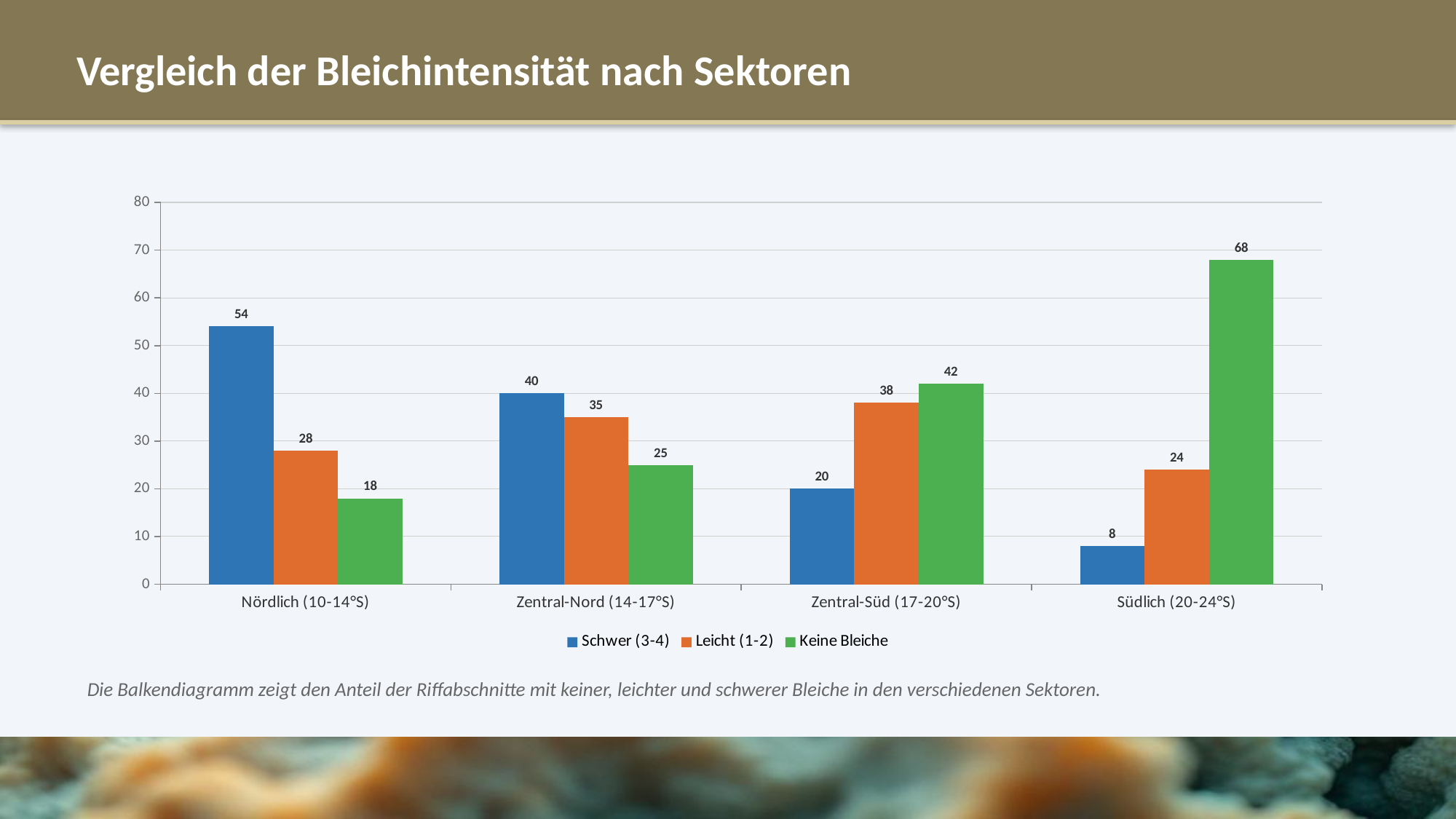
Do the Schwer (3-4) values rise or fall from Nördlich to Südlich along the x axis? Fall What is the value for Schwer (3-4) in the Nördlich (10-14°S) sector? 54 What kind of chart is shown on the slide? Bar chart What is the title of the slide? Vergleich der Bleichintensität nach Sektoren Which sector has the highest value for Schwer (3-4)? Nördlich (10-14°S) How many series does the legend list? 3 What is the value for Leicht (1-2) in the Zentral-Süd (17-20°S) sector? 38 Which sector has the lowest value for Keine Bleiche? Nördlich (10-14°S) In the Zentral-Nord (14-17°S) sector, which is larger: Schwer (3-4) or Leicht (1-2)? Schwer (3-4) What is the value for Keine Bleiche in the Südlich (20-24°S) sector? 68 What is the difference between the Keine Bleiche value and the Schwer (3-4) value in the Südlich (20-24°S) sector? 60 How many sectors are shown on the x axis? 4